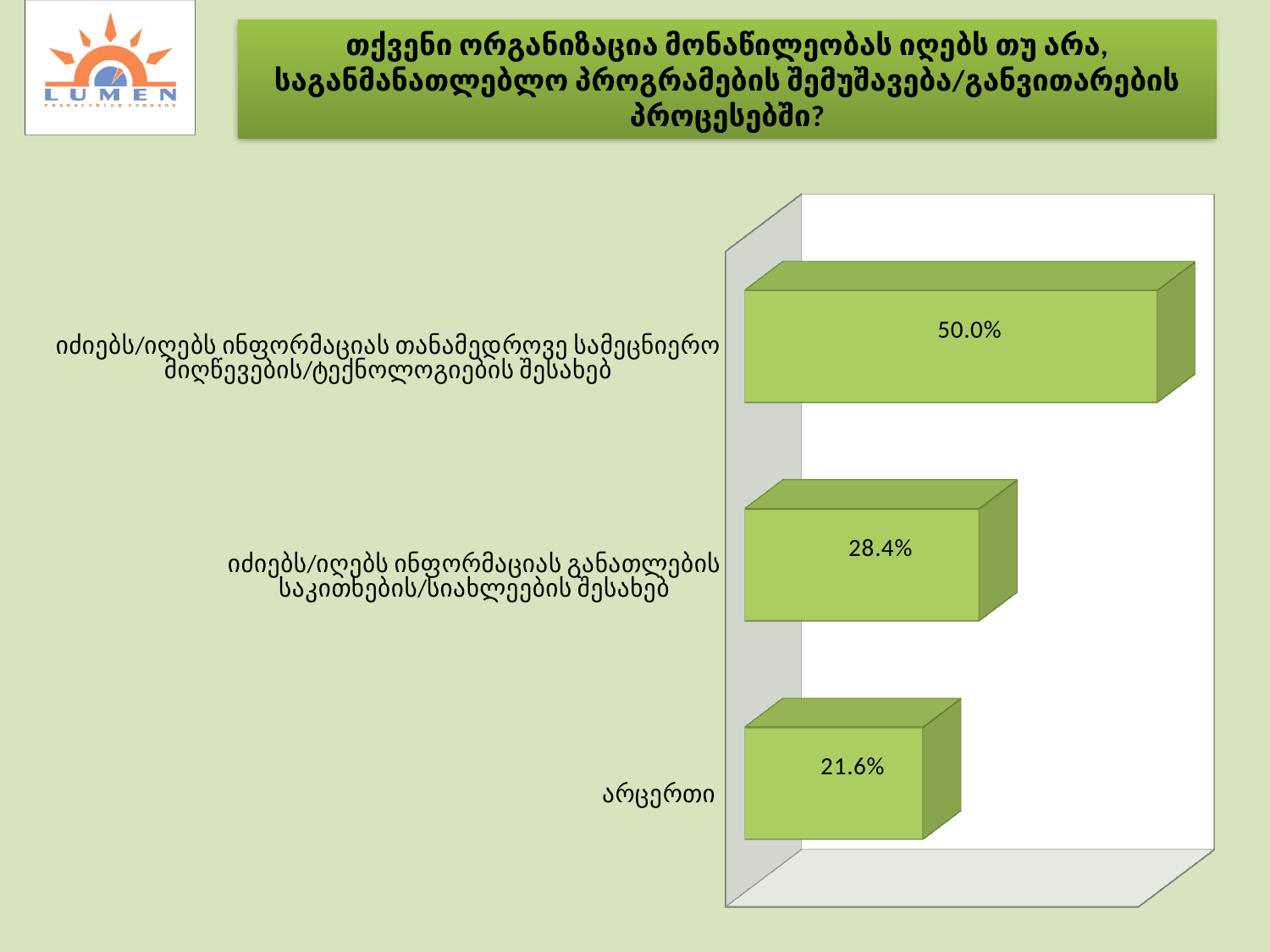
What colour are the bars in the chart? Green What is the total of the three values shown in the chart? 100.0% Which is larger: the value for "იძიებს/იღებს ინფორმაციას განათლების საკითხების/სიახლეების შესახებ" or the value for "არცერთი"? იძიებს/იღებს ინფორმაციას განათლების საკითხების/სიახლეების შესახებ Which category has the highest value? იძიებს/იღებს ინფორმაციას თანამედროვე სამეცნიერო მიღწევების/ტექნოლოგიების შესახებ What is the value for the category "არცერთი"? 21.6% What is the value for "იძიებს/იღებს ინფორმაციას განათლების საკითხების/სიახლეების შესახებ"? 28.4% What is the value for "იძიებს/იღებს ინფორმაციას თანამედროვე სამეცნიერო მიღწევების/ტექნოლოგიების შესახებ"? 50.0% What is the difference between the value for "იძიებს/იღებს ინფორმაციას თანამედროვე სამეცნიერო მიღწევების/ტექნოლოგიების შესახებ" and the value for "არცერთი"? 28.4% What kind of chart is shown on the slide? Bar chart What is the difference between the value for "იძიებს/იღებს ინფორმაციას განათლების საკითხების/სიახლეების შესახებ" and the value for "არცერთი"? 6.8% How many categories are shown in the chart? 3 Which category has the lowest value? არცერთი